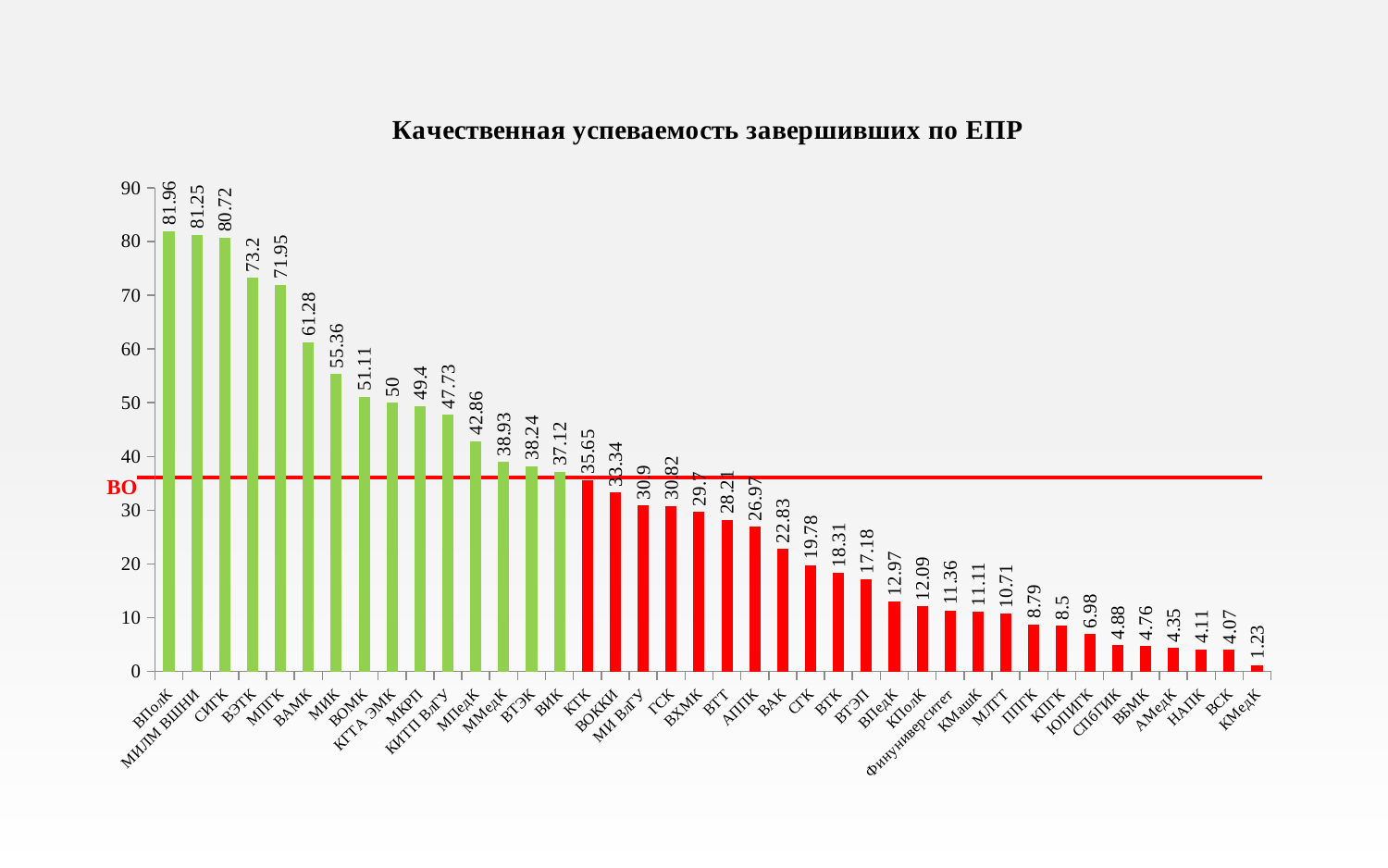
What type of chart is shown on the slide? bar chart Do the values rise or fall from left to right along the x axis? fall What is the value for ВПолК? 81.96 What is the title of the chart? Качественная успеваемость завершивших по ЕПР What is the difference between the values for ВПолК and КМедК? 80.73 Which has a larger value, ВАМК or ВАК? ВАМК How many categories are shown on the x axis? 40 What is the value for Финуниверситет? 11.36 Which category has the lowest value? КМедК Which category has the highest value? ВПолК What is the value for КГТА ЭМК? 50